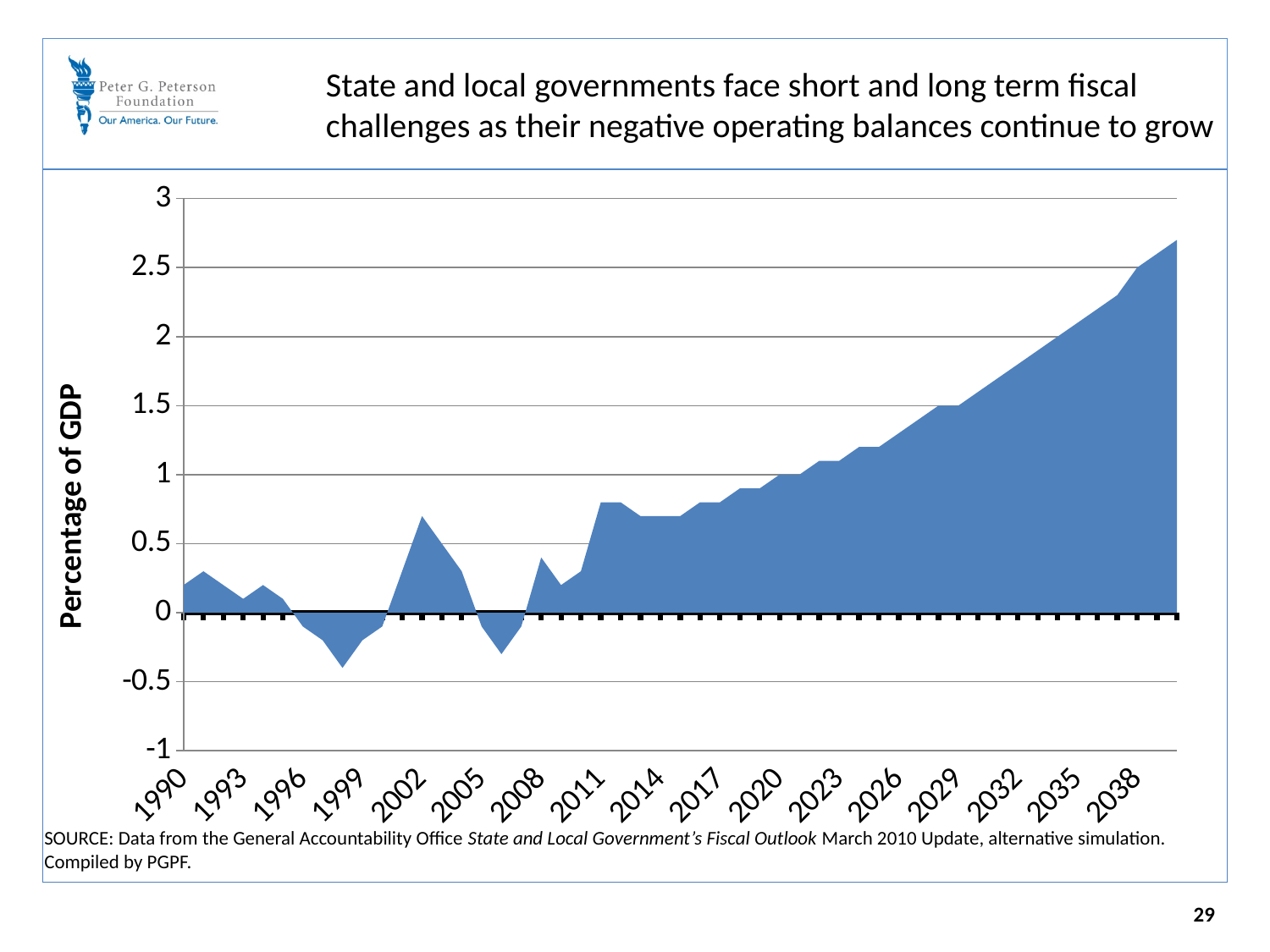
Is the value for 2002 greater or less than 0.5? greater Which is larger, the value for 2032 or the value for 2014? 2032 Is the value for 2017 greater or less than 1? less Is the value for 2011 greater or less than 0.5? greater What kind of chart is shown on the slide? Area chart In which labeled year is the value lowest? 1999 What is the first year shown on the horizontal axis? 1990 What is the label of the vertical axis? Percentage of GDP Do the values generally rise or fall from 2008 to the end of the chart? rise